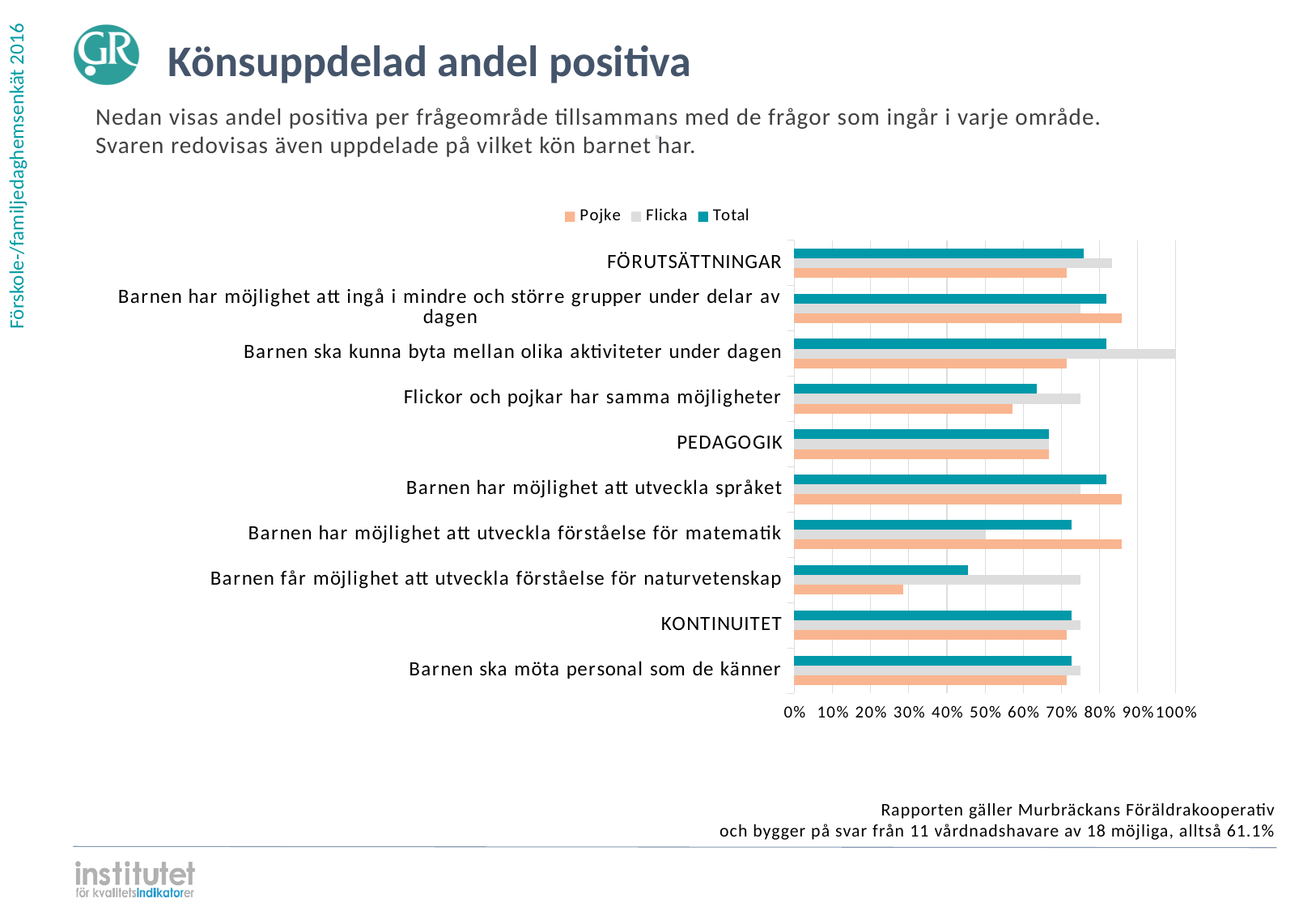
What are the three series named in the chart legend? Pojke, Flicka, Total What is the Flicka value for 'Barnen ska kunna byta mellan olika aktiviteter under dagen'? 100% Is the Pojke value for 'Barnen får möjlighet att utveckla förståelse för naturvetenskap' greater or less than 40%? less Which category has the highest Flicka value? Barnen ska kunna byta mellan olika aktiviteter under dagen For 'Barnen har möjlighet att utveckla förståelse för matematik', which is larger: the Pojke value or the Flicka value? Pojke For 'Barnen får möjlighet att utveckla förståelse för naturvetenskap', which is larger: the Pojke value or the Flicka value? Flicka Is the Flicka value for 'Barnen har möjlighet att utveckla förståelse för matematik' greater or less than 60%? less Which category has the lowest Pojke value? Barnen får möjlighet att utveckla förståelse för naturvetenskap How many categories are plotted on the y axis of the chart? 10 How many series does the chart legend list? 3 What kind of chart is shown on the slide? bar chart Is the Total value for 'Barnen får möjlighet att utveckla förståelse för naturvetenskap' greater or less than 50%? less